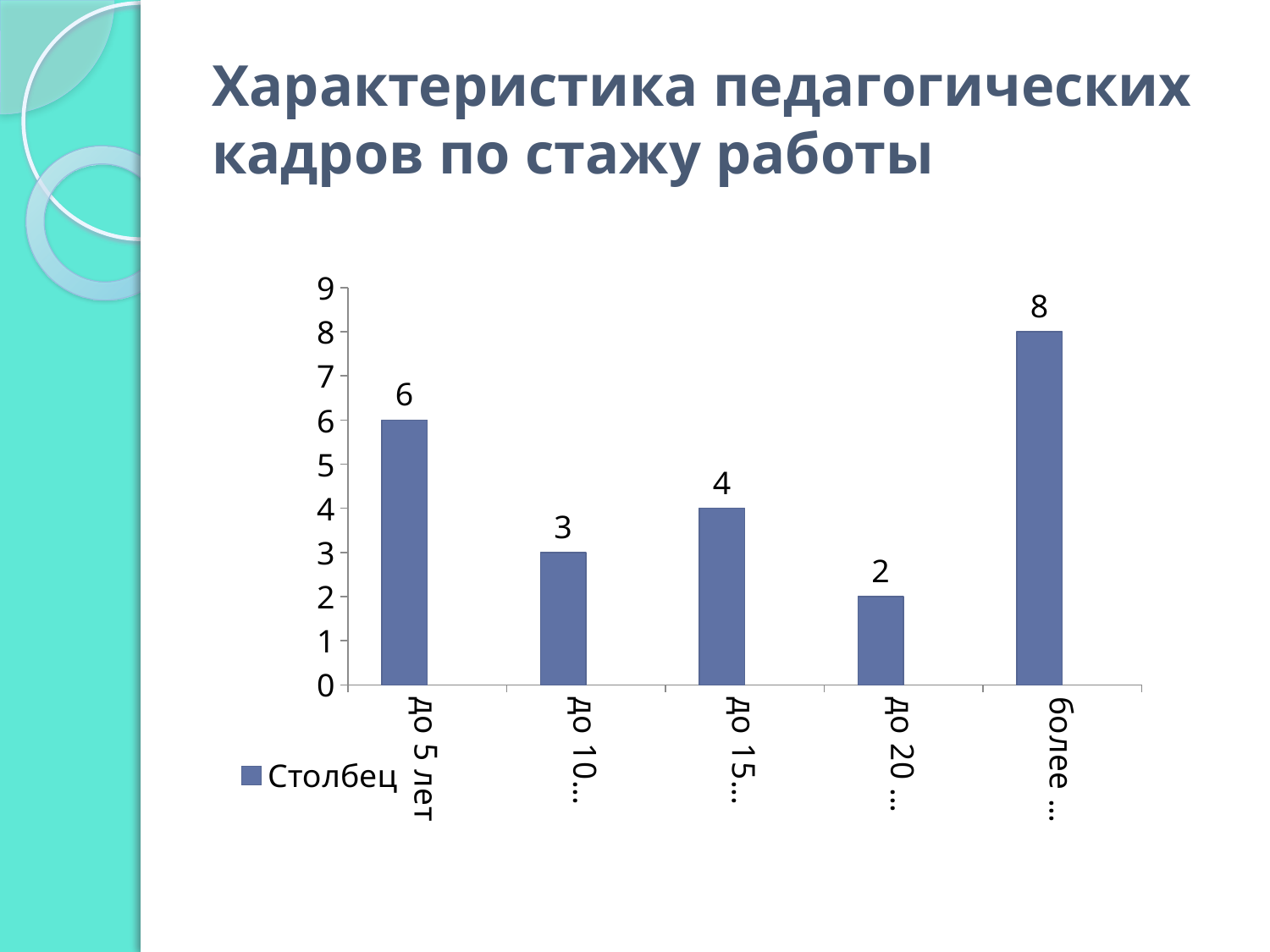
What is the difference between the values for "более …" and "до 5 лет"? 2 What is the value for the category labelled "до 20 …"? 2 Which category has the lowest value? до 20 … What is the value for the category labelled "до 10…"? 3 What is the value for the category "до 5 лет"? 6 What is the legend entry shown on the chart? Столбец What is the value for the category labelled "более …"? 8 Which category has the highest value? более … What is the value for the category labelled "до 15…"? 4 What kind of chart is shown on the slide? bar chart How many categories are shown on the chart? 5 Which is larger, the value for "до 10…" or the value for "до 15…"? до 15…